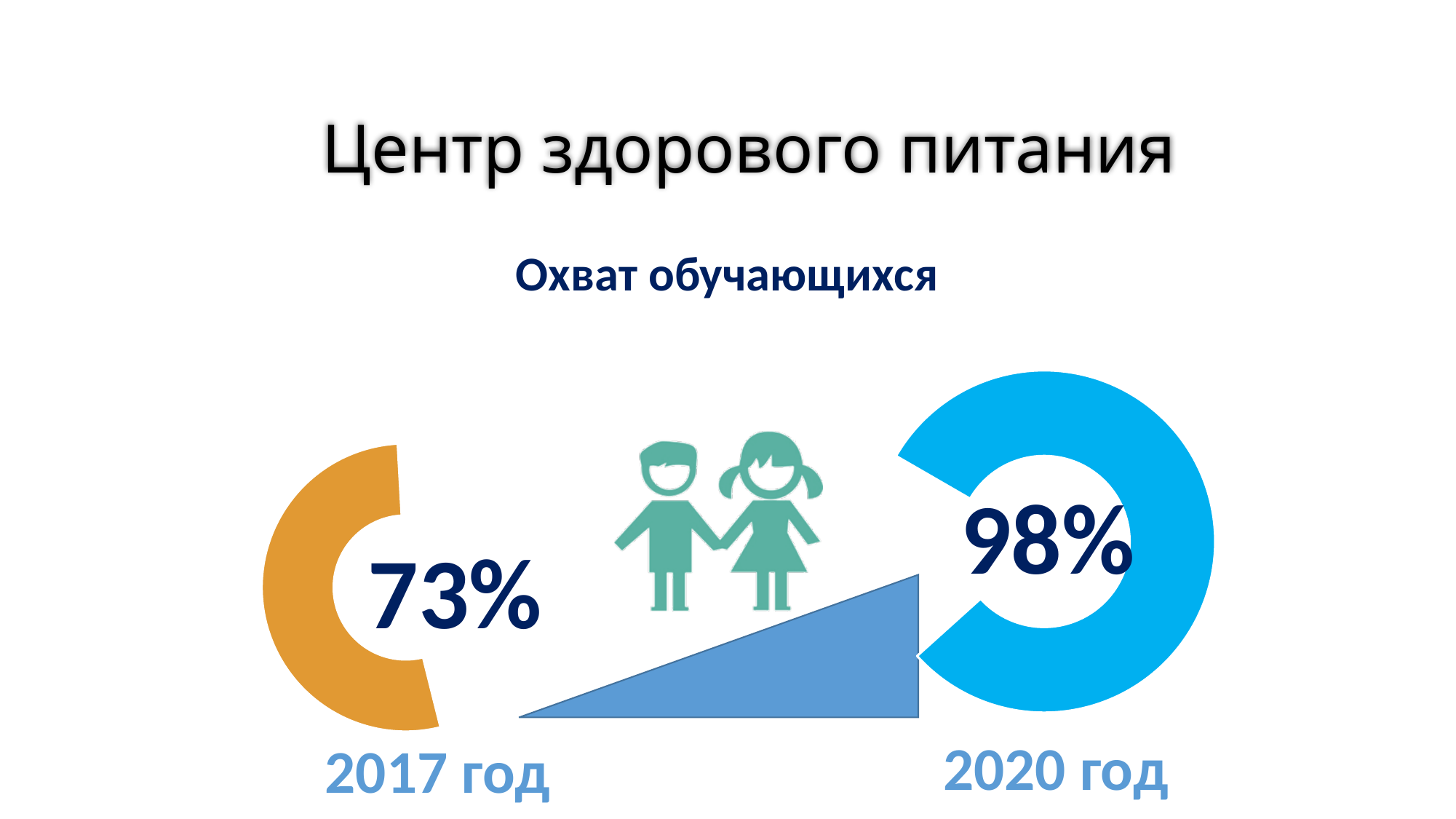
What is the subtitle above the charts? Охват обучающихся What colour is the ring for 2017 год? orange What is the value shown for 2020 год? 98% Which year has the lowest value shown on the slide? 2017 год What kind of chart is used to show the values for each year? donut (ring) chart By how many percentage points does the 2020 год value exceed the 2017 год value? 25 percentage points Which year has the highest value shown on the slide? 2020 год What is the value shown for 2017 год? 73% How many years are shown with values on the slide? 2 Does the coverage value rise or fall from 2017 год to 2020 год? rise Which year shows the higher coverage value, 2017 год or 2020 год? 2020 год